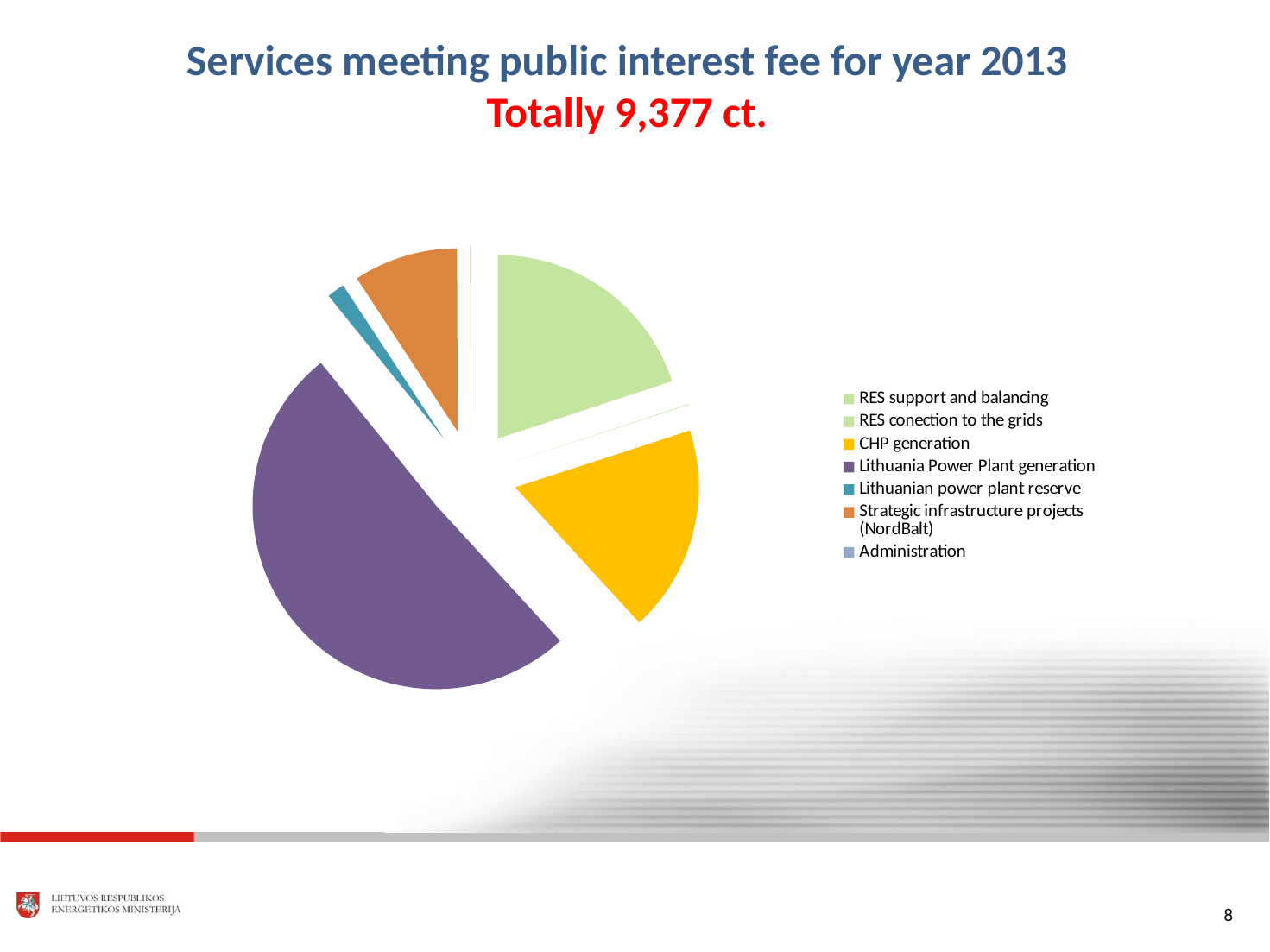
What colour is the CHP generation slice in the pie chart? yellow Which slice is larger: RES support and balancing or Lithuanian power plant reserve? RES support and balancing What kind of chart is shown on the slide? pie chart Which category has the largest slice of the pie chart? Lithuania Power Plant generation Which slice is larger: Strategic infrastructure projects (NordBalt) or Lithuanian power plant reserve? Strategic infrastructure projects (NordBalt) What total amount is stated under the chart title? 9,377 ct. Which slice is larger: Lithuania Power Plant generation or CHP generation? Lithuania Power Plant generation How many categories does the legend of the pie chart list? 7 How many data series does the pie chart show? 1